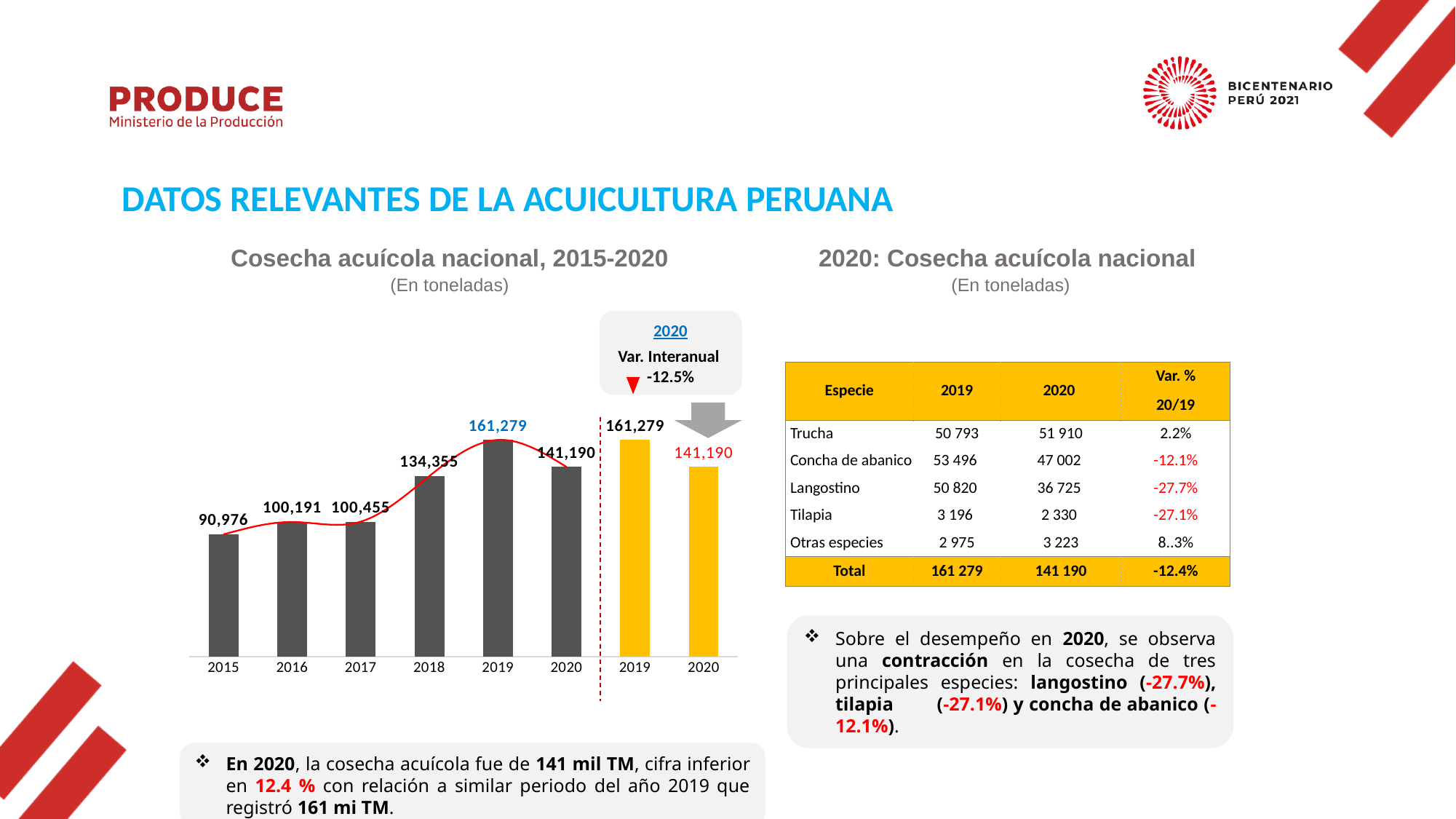
In the 'Cosecha acuícola nacional, 2015-2020' chart, what is the difference between the 2018 value and the 2017 value? 33,900 What is the value for 2015 in the 'Cosecha acuícola nacional, 2015-2020' chart? 90,976 Which year has the highest value in the 'Cosecha acuícola nacional, 2015-2020' chart? 2019 What is the value for 2020 in the 'Cosecha acuícola nacional, 2015-2020' chart? 141,190 How many bars are plotted in the 'Cosecha acuícola nacional, 2015-2020' chart, including the two yellow bars? 8 In the 'Cosecha acuícola nacional, 2015-2020' chart, which is larger, the value for 2016 or the value for 2017? 2017 In the 'Cosecha acuícola nacional, 2015-2020' chart, what is the difference between the 2019 value and the 2020 value? 20,089 In the 'Cosecha acuícola nacional, 2015-2020' chart, do the values rise or fall from 2015 to 2019? Rise Which year has the lowest value in the 'Cosecha acuícola nacional, 2015-2020' chart? 2015 What kind of chart is 'Cosecha acuícola nacional, 2015-2020'? Combination bar and line chart What colour are the two bars to the right of the dashed line in the 'Cosecha acuícola nacional, 2015-2020' chart? Yellow What is the value for 2018 in the 'Cosecha acuícola nacional, 2015-2020' chart? 134,355